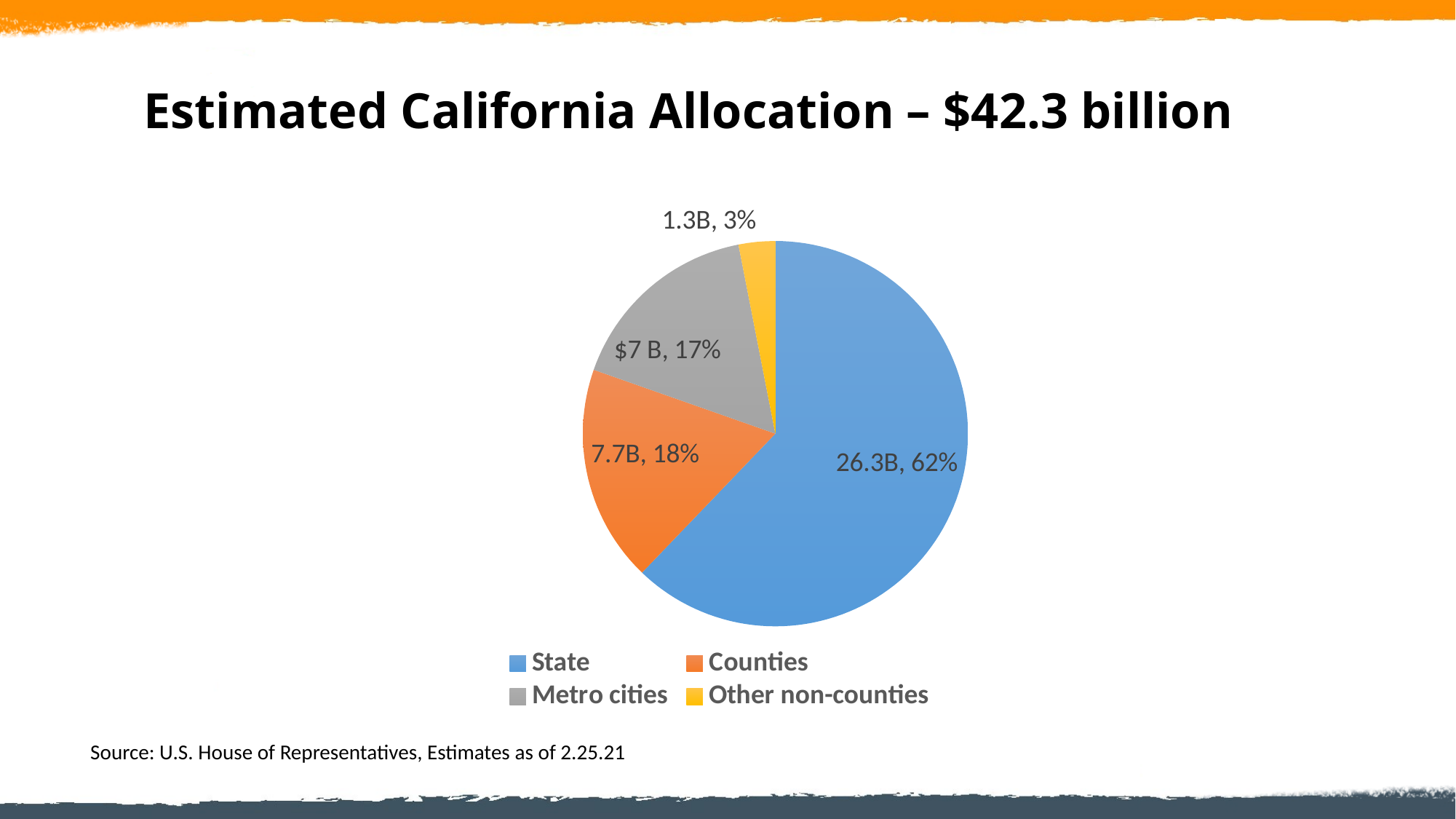
What share of the pie does the Other non-counties slice represent? 3% What share of the pie does the State slice represent? 62% How many slices does the pie chart have? 4 What value is shown for the Other non-counties slice? 1.3B What is the title of the slide? Estimated California Allocation – $42.3 billion Which category has the smallest slice? Other non-counties What value is shown for the Metro cities slice? $7 B What value is shown for the Counties slice? 7.7B What share of the pie does the Metro cities slice represent? 17% Which category has the largest slice? State What kind of chart is shown on the slide? pie chart What value is shown for the State slice? 26.3B